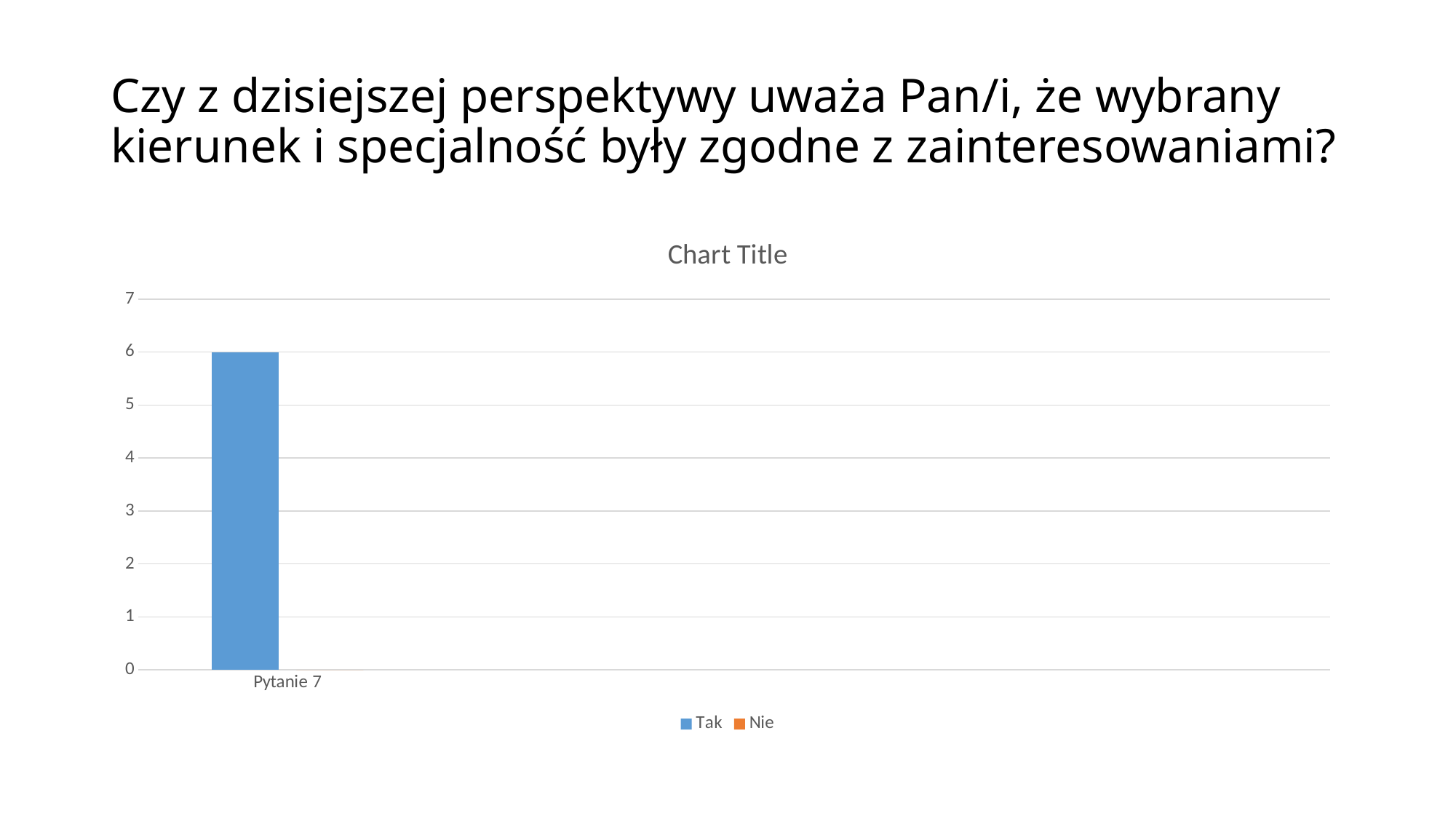
What is the value for Nie for Pytanie 7? 0 What is the category label on the x axis? Pytanie 7 How many categories are shown on the x axis? 1 How many series does the legend list? 2 Is the value for Tak greater or less than 7? less What type of chart is shown on the slide? bar chart What is the difference between the Tak and Nie values for Pytanie 7? 6 Is the value for Tak greater or less than 5? greater Which series has the higher value for Pytanie 7, Tak or Nie? Tak What are the series names listed in the legend? Tak, Nie Which series has the lowest value for Pytanie 7? Nie What is the value for Tak for Pytanie 7? 6